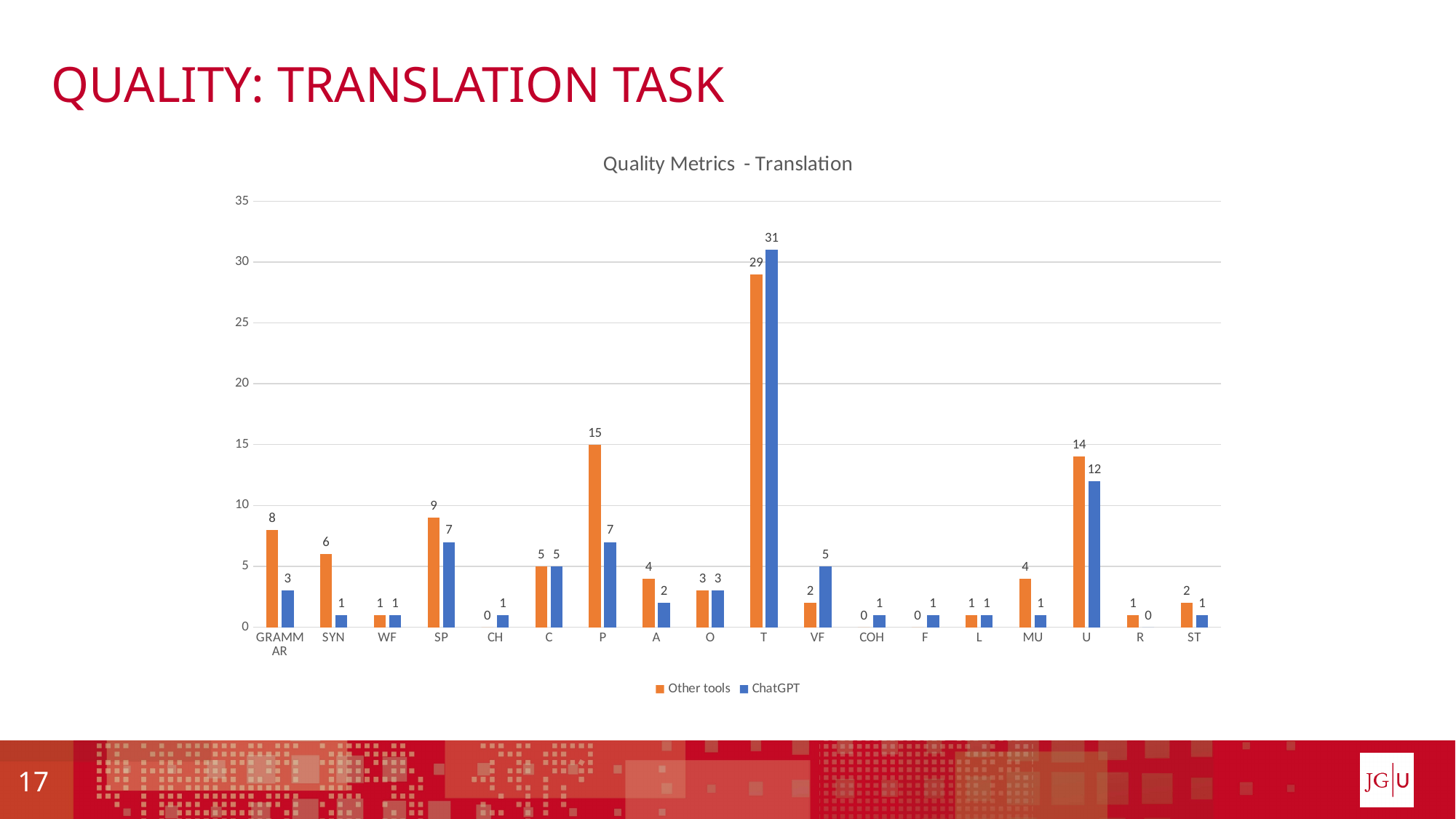
What is the value for Other tools in the T category? 29 Which is larger in the VF category, the Other tools value or the ChatGPT value? ChatGPT Which category has the highest ChatGPT value? T What is the title of the chart? Quality Metrics - Translation What is the value for Other tools in the P category? 15 Which category has the highest Other tools value? T What kind of chart is shown on the slide? Bar chart How many series does the legend list? 2 What is the value for ChatGPT in the U category? 12 What is the difference between the ChatGPT and Other tools values in the T category? 2 How many categories are shown on the x axis? 18 What is the difference between the Other tools and ChatGPT values in the P category? 8